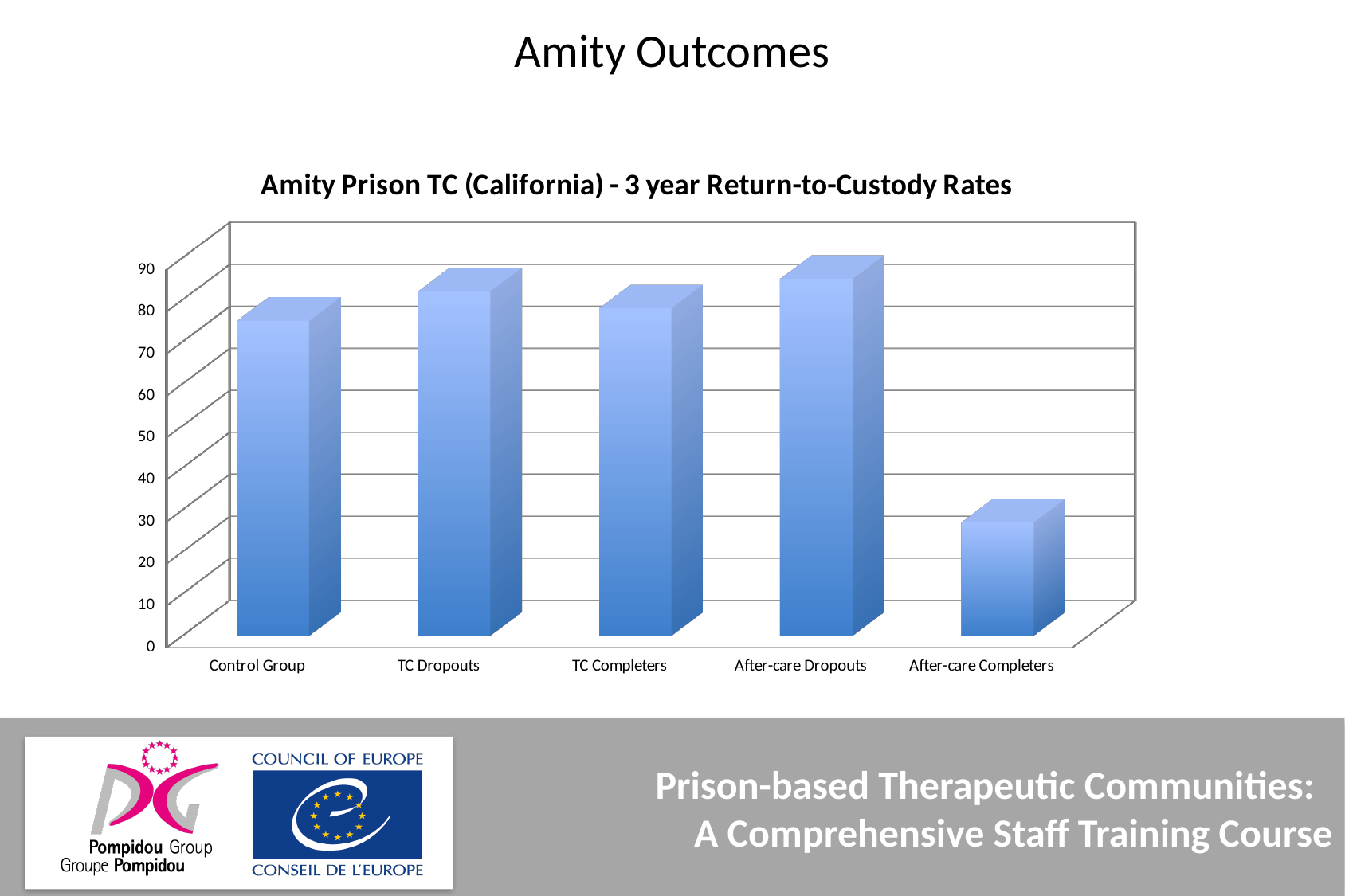
Is the value for Control Group greater or less than 70? greater Which category has the lowest return-to-custody rate? After-care Completers Which is larger, the value for Control Group or the value for After-care Dropouts? After-care Dropouts Is the value for After-care Dropouts greater or less than 80? greater How many categories are shown on the x axis of the chart? 5 Is the value for TC Dropouts greater or less than 70? greater Which is larger, the value for After-care Completers or the value for TC Completers? TC Completers What is the highest value labelled on the vertical axis of the chart? 90 Which category has the highest return-to-custody rate? After-care Dropouts What is the title of the chart? Amity Prison TC (California) - 3 year Return-to-Custody Rates What type of chart is shown on the slide? Bar chart